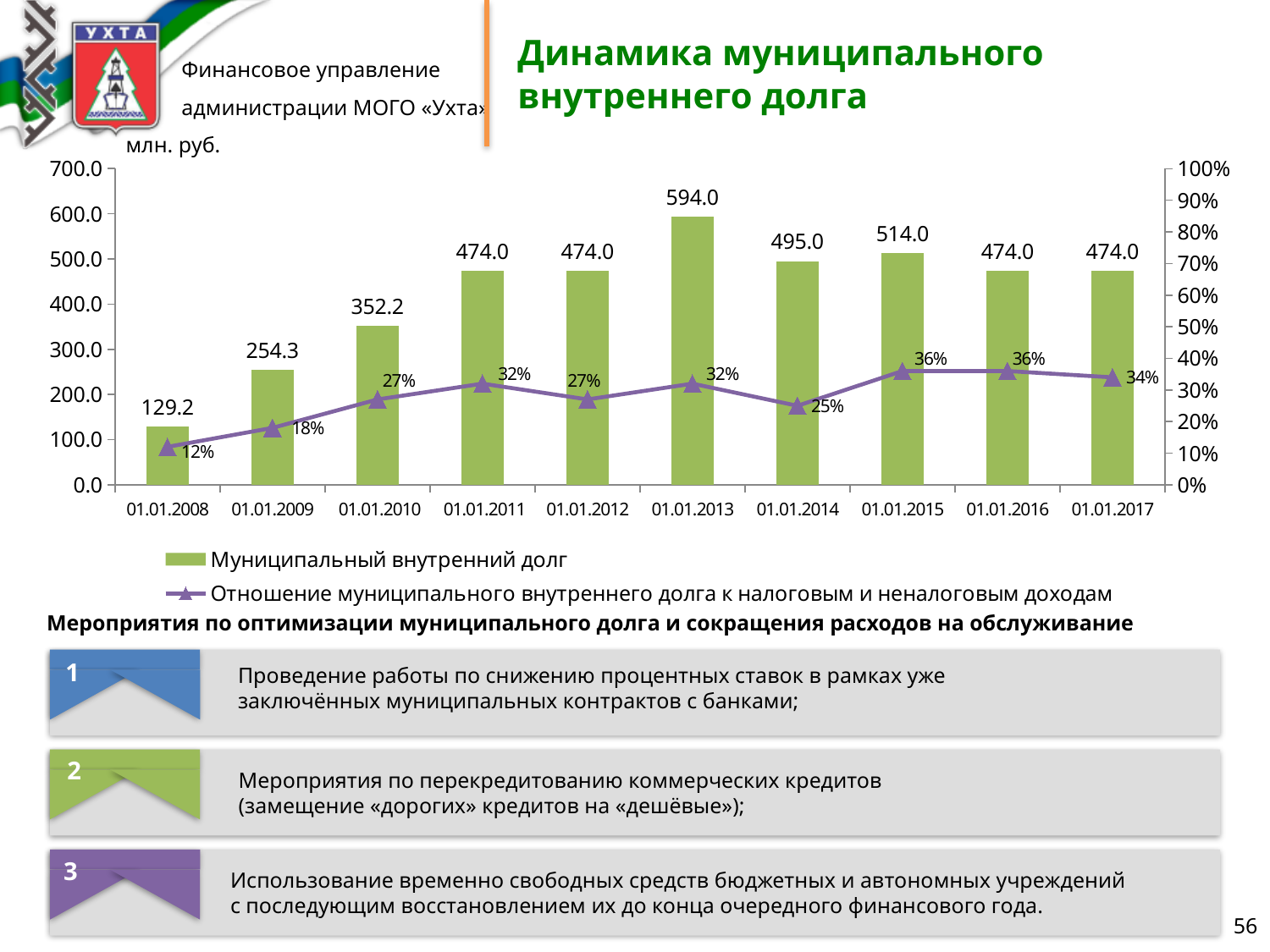
What is the value of the municipal internal debt (Муниципальный внутренний долг) on 01.01.2013? 594.0 What is the value of the municipal internal debt on 01.01.2008? 129.2 How many series does the chart legend list? 2 What is the ratio of municipal internal debt to tax and non-tax revenues on 01.01.2015? 36% What kind of chart is used to show the municipal internal debt? Bar chart Which is larger: the municipal internal debt on 01.01.2015 or on 01.01.2016? 01.01.2015 On which date is the municipal internal debt lowest? 01.01.2008 On which date is the municipal internal debt highest? 01.01.2013 How many dates are shown on the x axis of the chart? 10 What is the difference between the municipal internal debt on 01.01.2013 and on 01.01.2014? 99.0 What is the title of the chart? Динамика муниципального внутреннего долга What is the ratio of municipal internal debt to tax and non-tax revenues on 01.01.2017? 34%